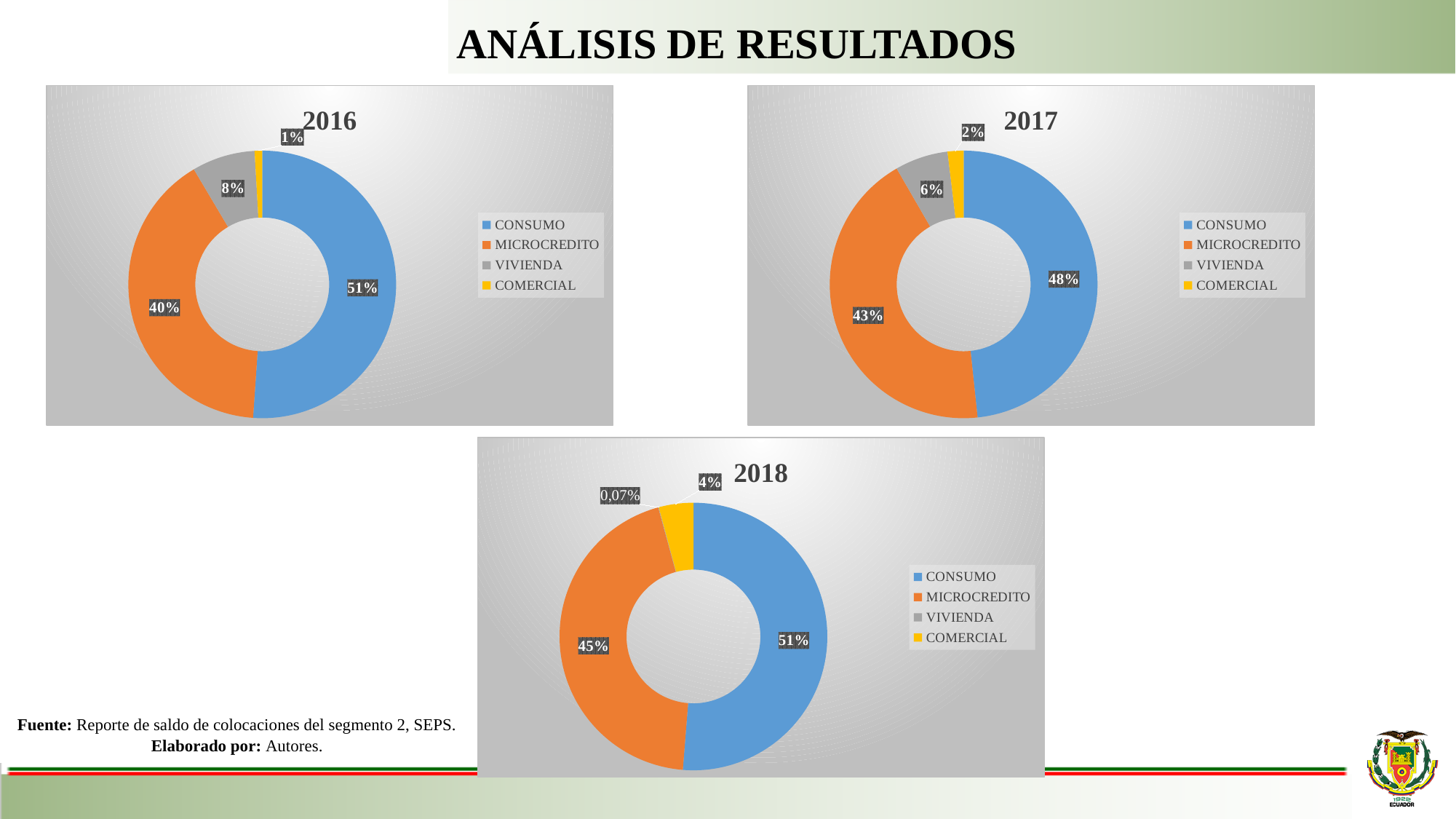
In the 2016 chart, what share does VIVIENDA have? 8% In the 2018 chart, what share does COMERCIAL have? 4% What kind of chart is the 2018 chart? doughnut chart How many charts are shown on the slide? 3 In the 2018 chart, which is larger, the share of MICROCREDITO or the share of COMERCIAL? MICROCREDITO In the 2017 chart, which category has the largest share? CONSUMO In the 2017 chart, what is the difference between the CONSUMO and MICROCREDITO shares? 5% In the 2017 chart, what share does MICROCREDITO have? 43% In the 2018 chart, what share does VIVIENDA have? 0,07% In the 2016 chart, which category has the smallest share? COMERCIAL In the 2016 chart, what share does CONSUMO have? 51% How many categories does the legend of the 2016 chart list? 4